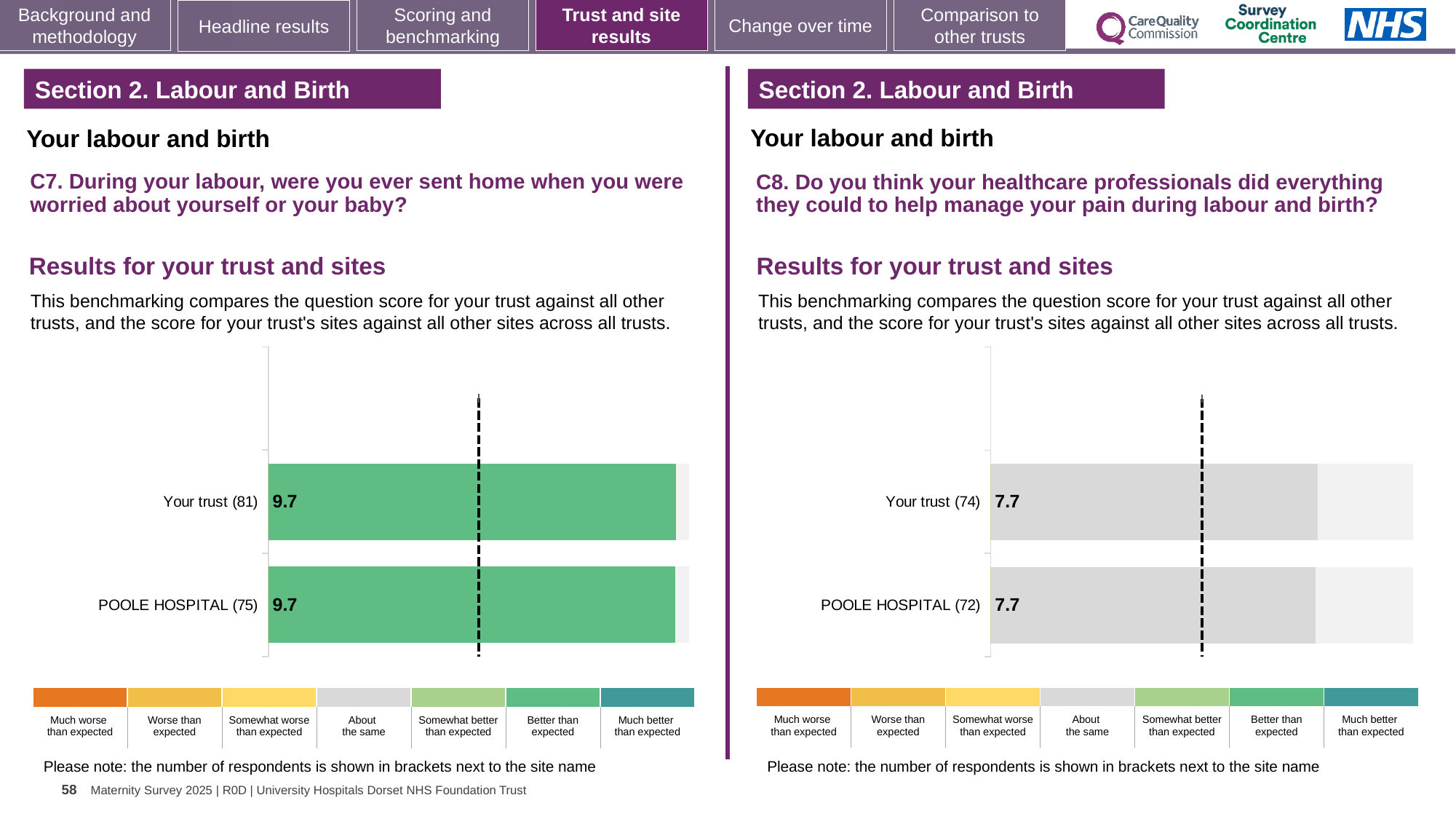
How many bars are plotted in the right chart (C8)? 2 What type of chart is used in the left chart (C7)? Bar chart In the right chart (C8), what is the score for POOLE HOSPITAL? 7.7 In the right chart (C8), how many respondents are shown in brackets for POOLE HOSPITAL? 72 In the left chart (C7), what is the difference between the Your trust score and the POOLE HOSPITAL score? 0 In the right chart (C8), what is the difference between the Your trust score and the POOLE HOSPITAL score? 0 How many bars are plotted in the left chart (C7)? 2 In the right chart (C8), what is the score for Your trust? 7.7 In the left chart (C7), how many respondents are shown in brackets for Your trust? 81 Is the Your trust score in the right chart (C8) greater or less than the Your trust score in the left chart (C7)? less In the left chart (C7), what is the score for Your trust? 9.7 In the left chart (C7), what is the score for POOLE HOSPITAL? 9.7